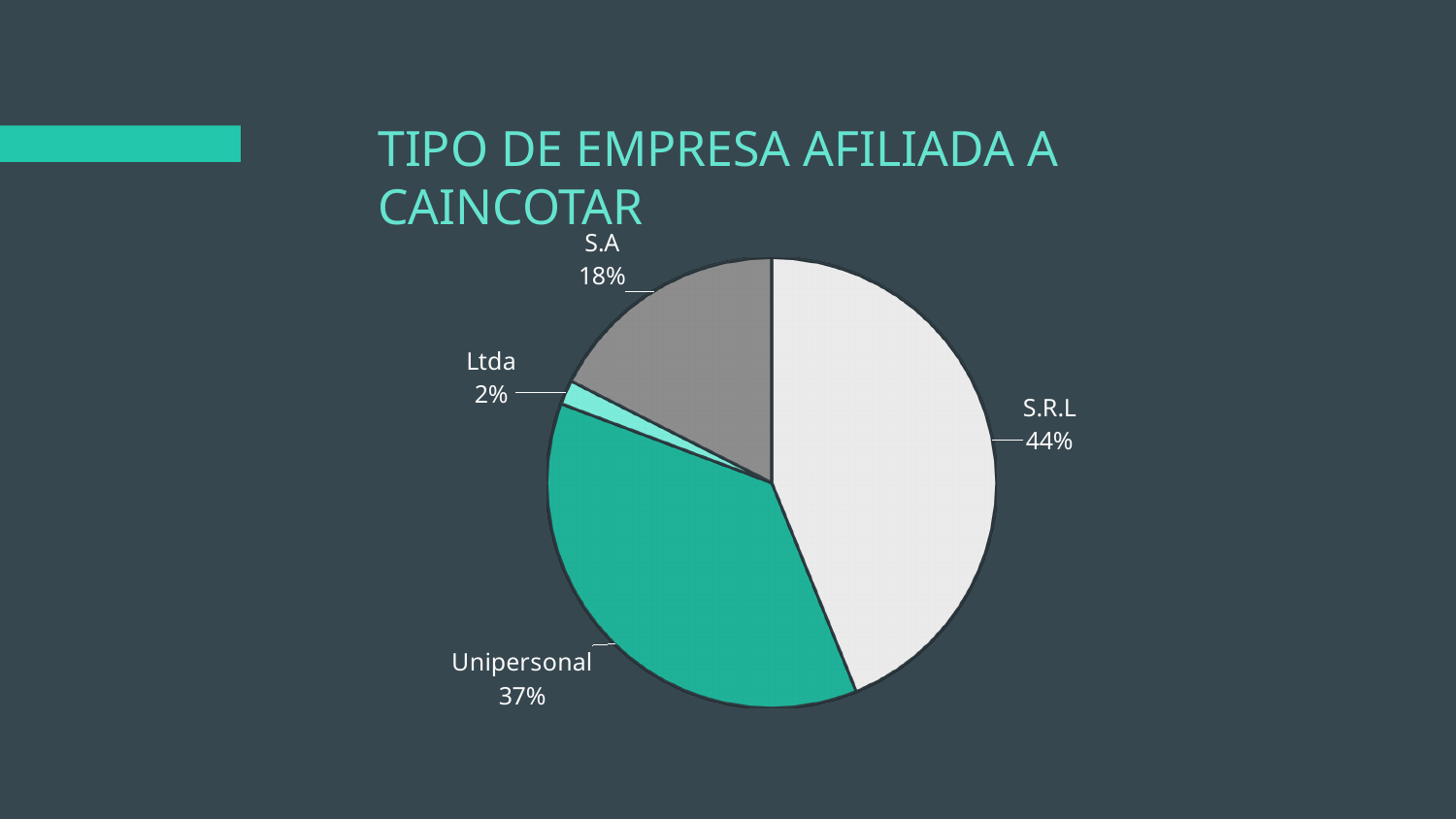
Which category has the smallest share of the pie chart? Ltda Which category has the largest share of the pie chart? S.R.L How many categories are shown in the pie chart? 4 What is the title of the chart on the slide? TIPO DE EMPRESA AFILIADA A CAINCOTAR Which has a larger share, S.A or Unipersonal? Unipersonal What percentage of the pie chart is S.A? 18% What is the difference in percentage points between S.R.L and Unipersonal? 7 What percentage of the pie chart is S.R.L? 44% What percentage of the pie chart is Ltda? 2% What kind of chart is shown on the slide? Pie chart What is the difference in percentage points between S.A and Ltda? 16 What percentage of the pie chart is Unipersonal? 37%